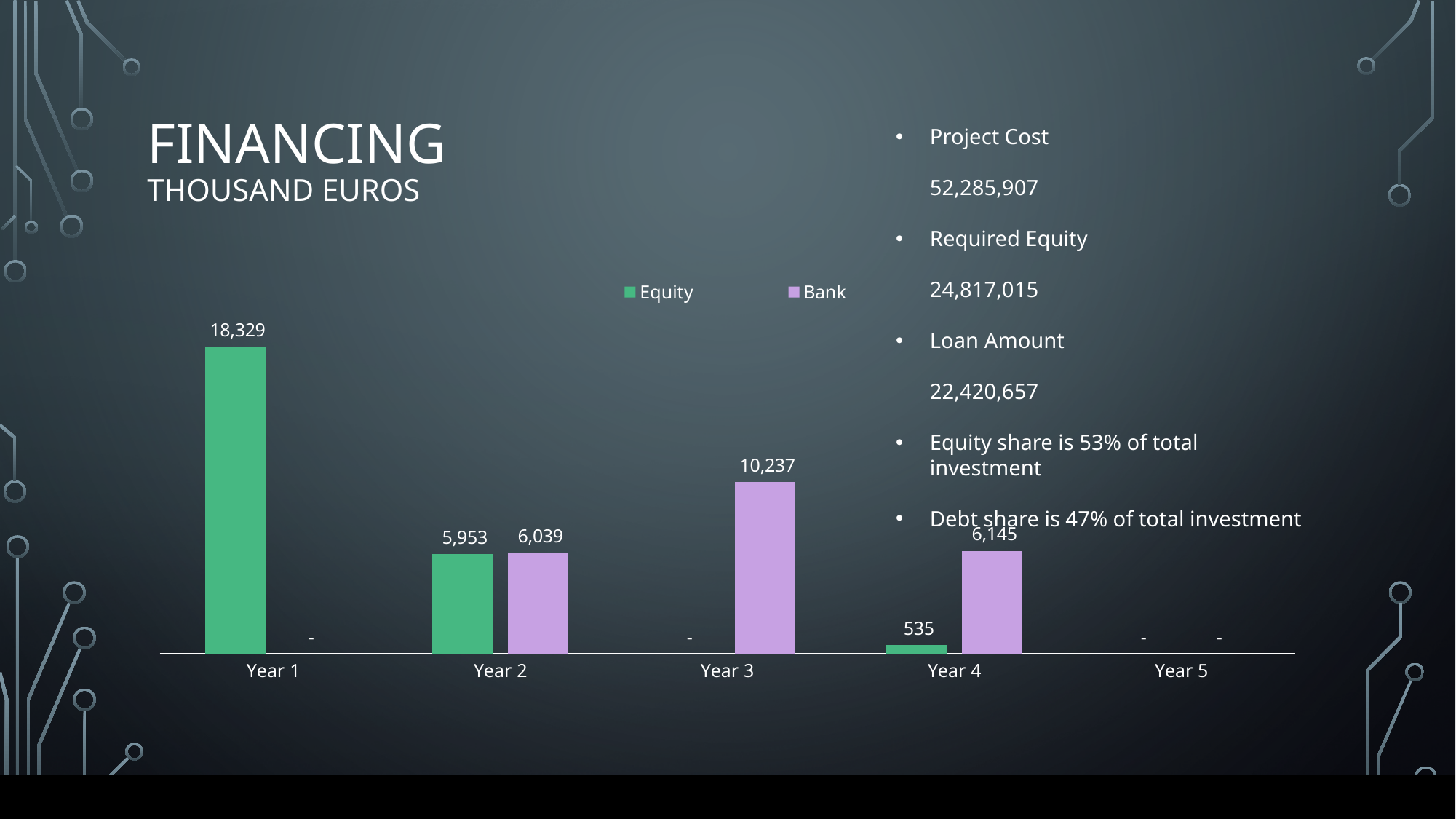
In Year 4, which is larger, the Equity value or the Bank value? Bank What is the difference between the Bank value and the Equity value in Year 2? 86 What type of chart is shown on the slide? Bar chart What is the Bank value for Year 3? 10,237 What is the Bank value for Year 2? 6,039 What is the Equity value for Year 1? 18,329 Which year has the highest Equity value? Year 1 What is the difference between the Bank value in Year 3 and the Bank value in Year 4? 4,092 How many series does the legend list? 2 How many year categories are shown on the x axis? 5 Which year has the highest Bank value? Year 3 What is the Equity value for Year 4? 535